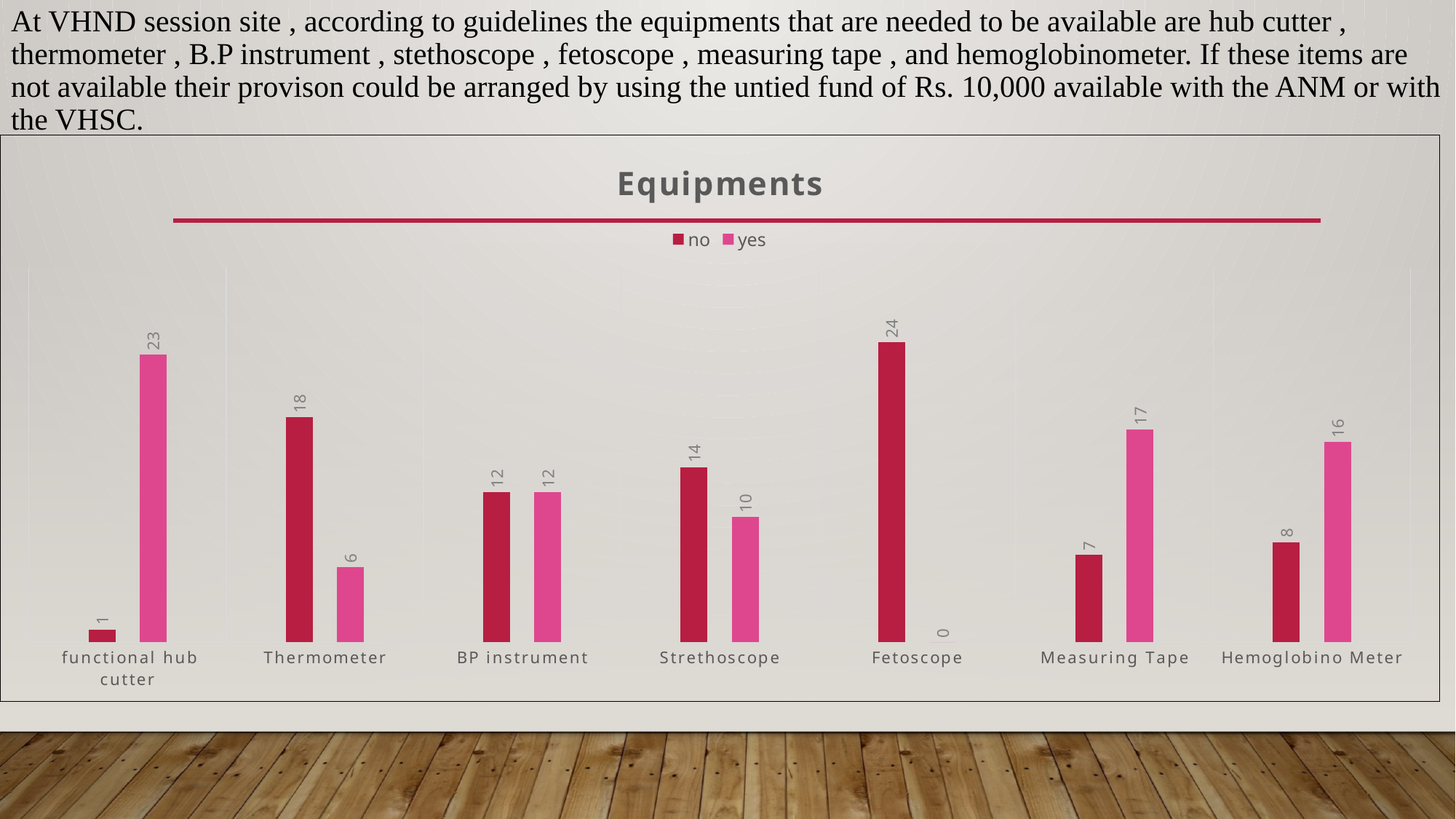
What is the 'no' value for Measuring Tape? 7 Which category has the lowest 'yes' value? Fetoscope How many series does the legend list? 2 Which is larger for Hemoglobino Meter, the 'no' value or the 'yes' value? yes What kind of chart is shown? bar chart What is the 'no' value for Fetoscope? 24 What is the 'yes' value for functional hub cutter? 23 What is the title of the chart? Equipments What is the 'yes' value for Thermometer? 6 Which category has the highest 'no' value? Fetoscope What is the difference between the 'no' and 'yes' values for Thermometer? 12 How many equipment categories are shown on the x axis? 7